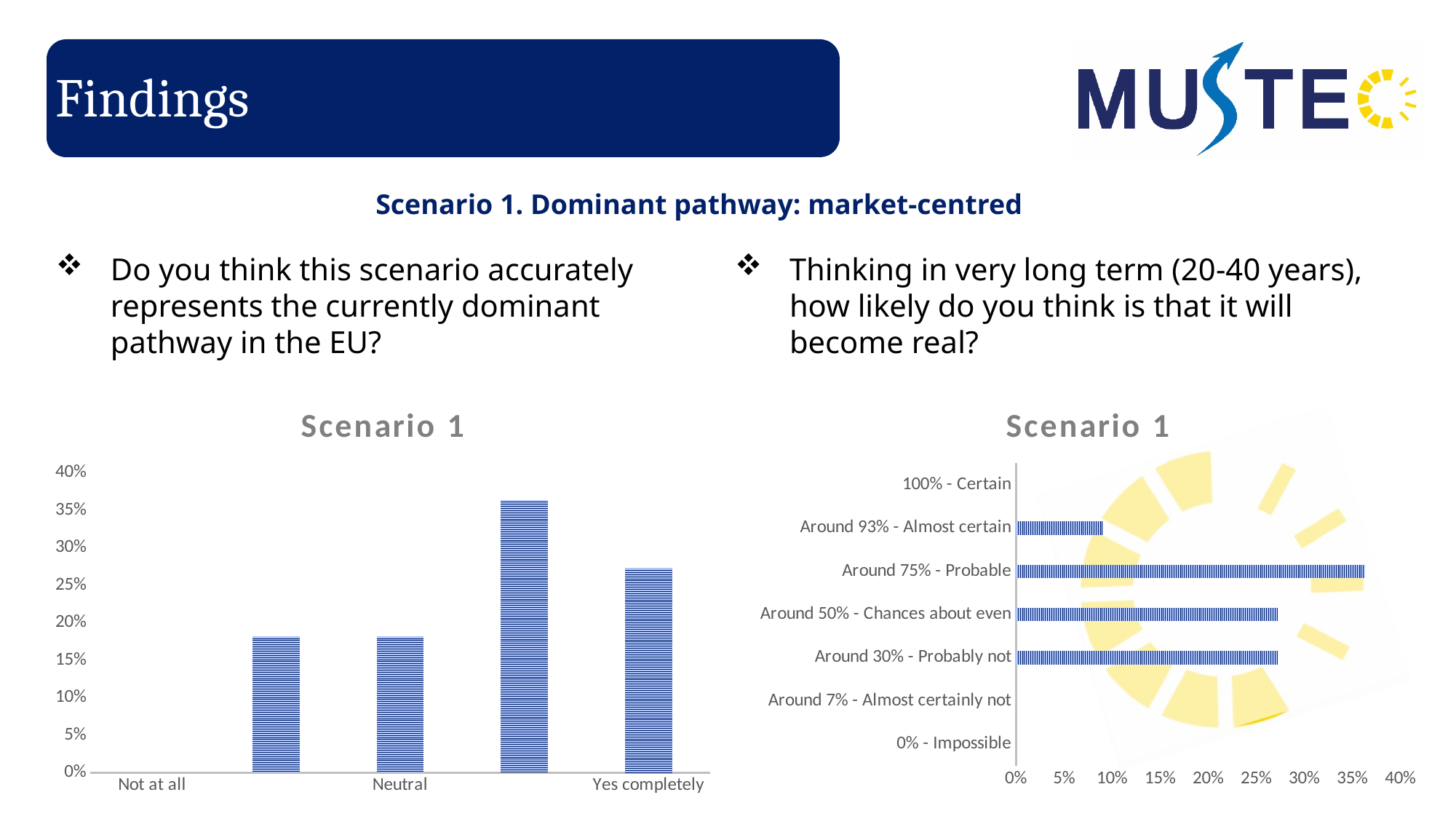
What kind of chart is the left chart titled 'Scenario 1'? bar chart In the left chart, is the value for Neutral greater or less than 15%? greater In the left chart, which is larger, the value for Neutral or the value for Yes completely? Yes completely How many categories are listed on the vertical axis of the right chart? 7 In the left chart, is the value for Yes completely greater or less than 30%? less In the right chart, which category has the highest value? Around 75% - Probable In the right chart, is the value for Around 75% - Probable greater or less than 30%? greater What kind of chart is the right chart titled 'Scenario 1'? bar chart In the right chart, which is larger, the value for Around 75% - Probable or the value for Around 93% - Almost certain? Around 75% - Probable